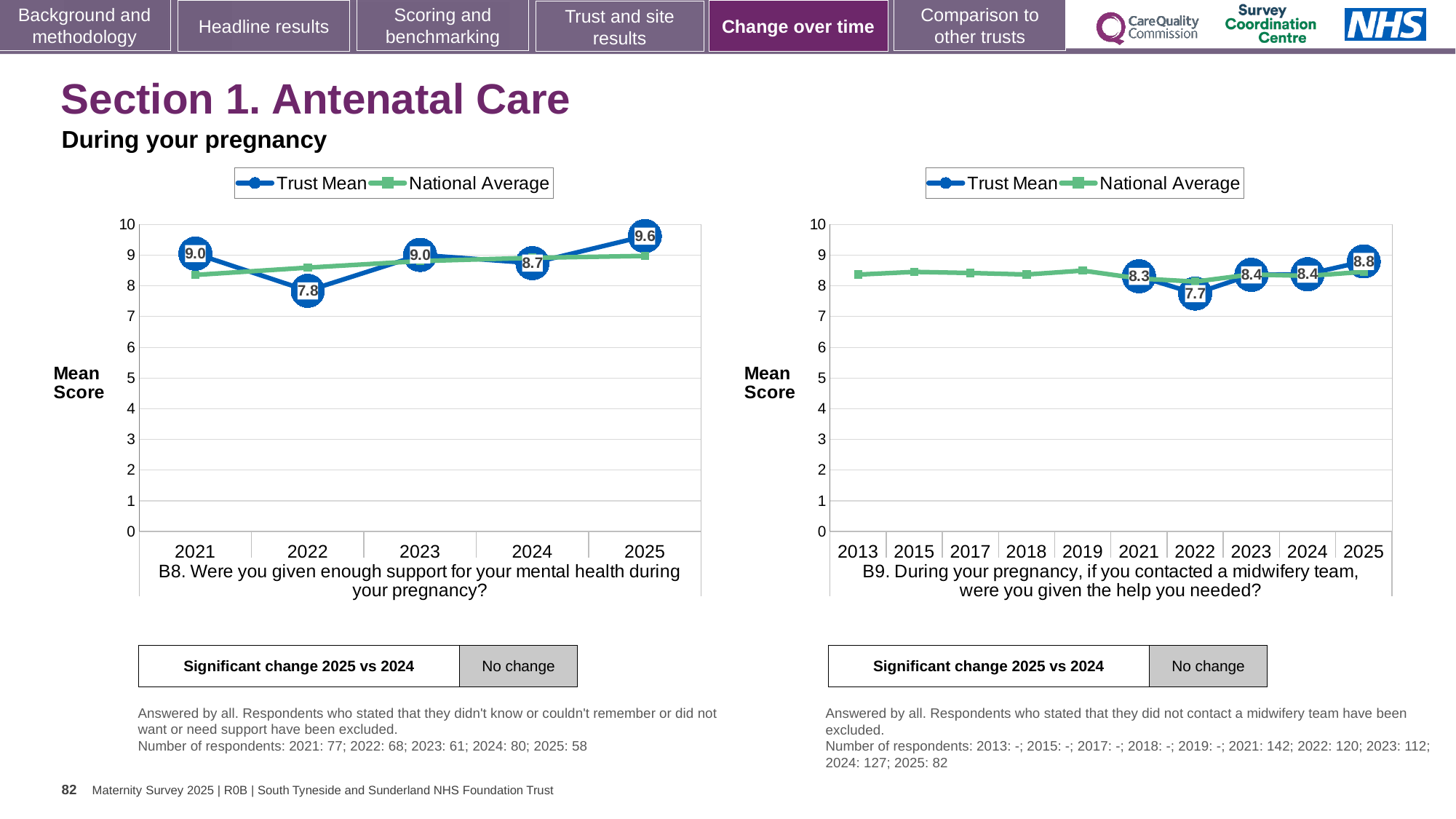
In the B8 chart on the left, which year has the lowest Trust Mean? 2022 How many years are shown on the x axis of the B9 chart on the right? 10 In the B8 chart on the left, what is the Trust Mean for 2022? 7.8 In the B8 chart on the left, which year has the highest Trust Mean? 2025 In the B9 chart on the right, what is the Trust Mean for 2025? 8.8 How many series does the legend of the B8 chart on the left list? 2 What kind of chart is the B8 chart on the left? Line chart In the B9 chart on the right, which is larger, the Trust Mean for 2021 or the Trust Mean for 2025? 2025 In the B8 chart on the left, what is the Trust Mean for 2025? 9.6 In the B9 chart on the right, what is the Trust Mean for 2022? 7.7 In the B9 chart on the right, is the National Average for 2013 greater or less than 8? greater In the B8 chart on the left, what is the difference between the Trust Mean for 2025 and the Trust Mean for 2024? 0.9